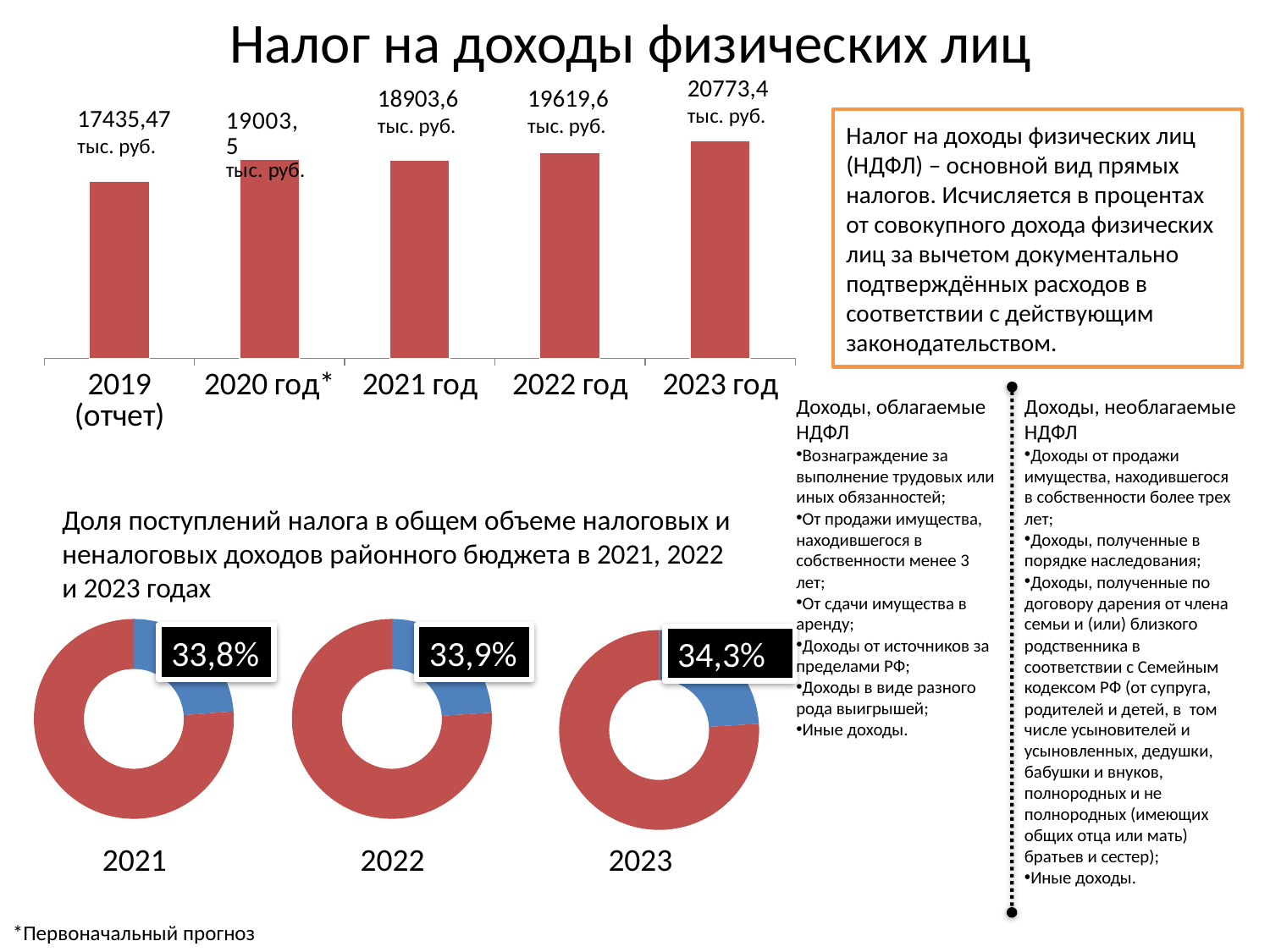
In the bar chart, which year has the highest value? 2023 год In the bar chart, what is the value for 2023 год? 20773,4 тыс. руб. In the bar chart, which year has the lowest value? 2019 (отчет) In the bar chart, what is the difference between the values for 2022 год and 2021 год? 716,0 тыс. руб. In the donut charts at the bottom, what share is shown for 2023? 34,3% In the bar chart, do the values generally rise or fall from 2019 to 2023? rise In the bar chart, what is the value for 2019 (отчет)? 17435,47 тыс. руб. In the bar chart, which is larger: the value for 2020 год* or the value for 2021 год? 2020 год* How many bars are in the bar chart at the top of the slide? 5 What kind of chart is shown at the top of the slide? bar chart In the donut charts at the bottom, which year shows the highest share? 2023 In the bar chart, what is the value for 2021 год? 18903,6 тыс. руб.